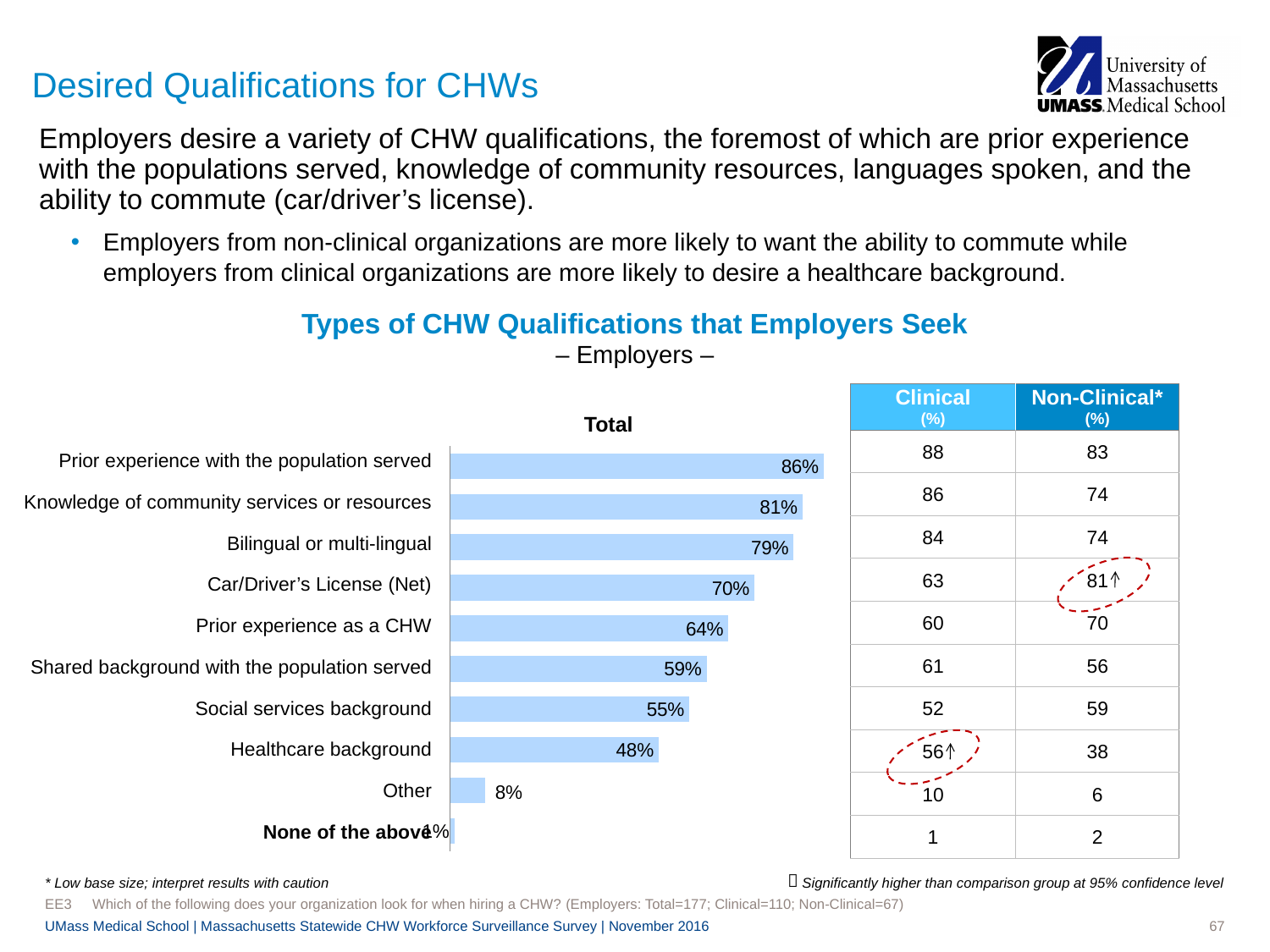
Which qualification has the highest Total value? Prior experience with the population served Which has a larger Total value, Shared background with the population served or Social services background? Shared background with the population served What is the Total value for Prior experience with the population served? 86% Do the Total values rise or fall going down the chart from the top category to the bottom? fall What type of chart is shown on the slide? bar chart What is the Total value for Car/Driver's License (Net)? 70% What is the difference between the Total values for Knowledge of community services or resources and Bilingual or multi-lingual? 2% What is the difference between the Total values for Prior experience as a CHW and Social services background? 9% How many qualification categories are shown in the bar chart? 10 What is the title of the chart? Types of CHW Qualifications that Employers Seek What is the Total value for Healthcare background? 48% What is the Total value for Other? 8%